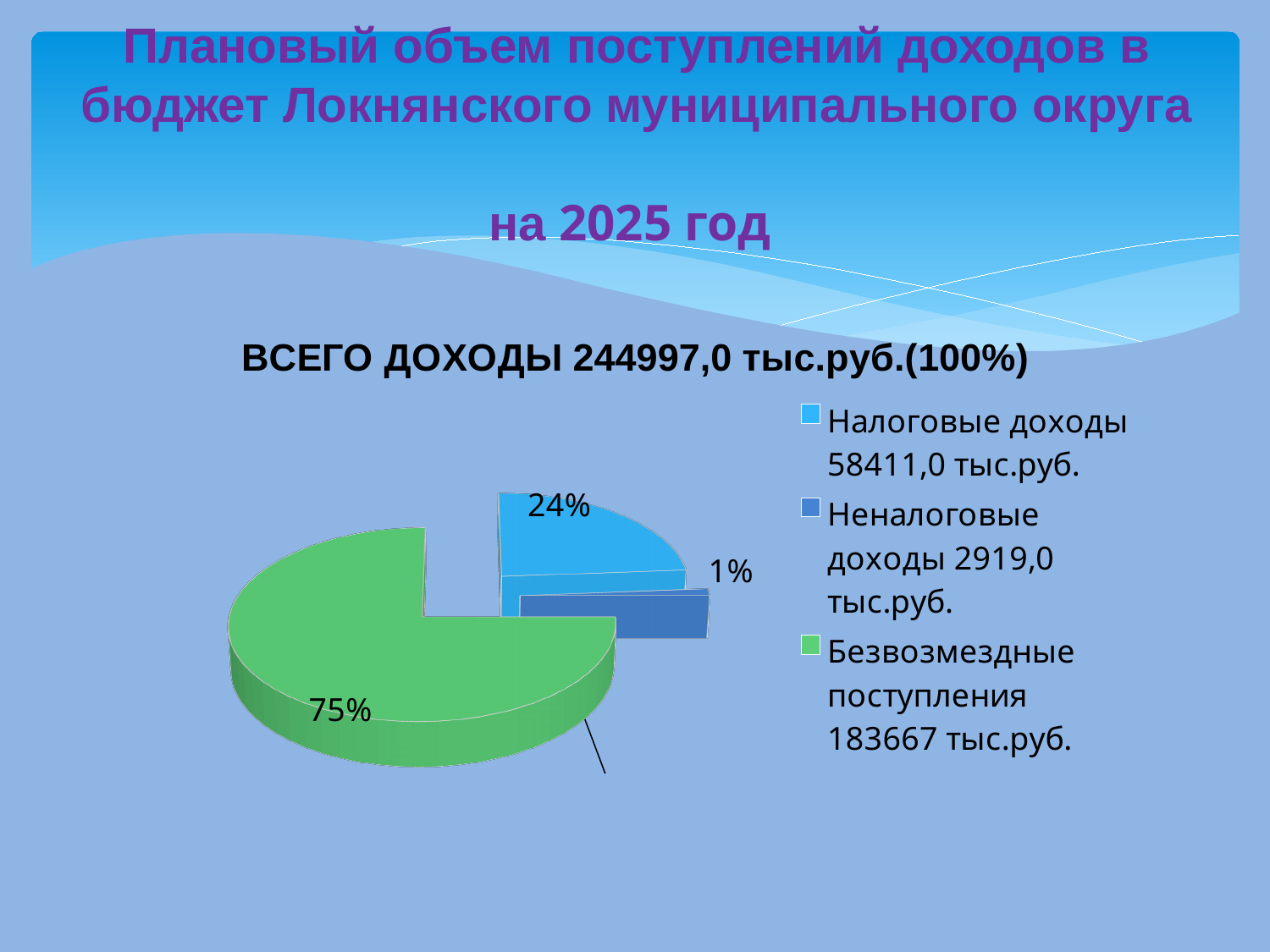
How many entries does the legend list? 3 What amount does the legend give for Налоговые доходы? 58411,0 тыс.руб. What share of the pie is labelled for Неналоговые доходы? 1% Which is larger: the share for Налоговые доходы or the share for Неналоговые доходы? Налоговые доходы What colour is the slice for Безвозмездные поступления? green How many slices does the pie chart have? 3 Which category has the largest slice of the pie? Безвозмездные поступления Which category has the smallest slice of the pie? Неналоговые доходы What share of the pie is labelled for Безвозмездные поступления? 75% What share of the pie is labelled for Налоговые доходы? 24% What kind of chart is shown on the slide? pie chart What is the difference in percentage points between the Безвозмездные поступления slice and the Налоговые доходы slice? 51%